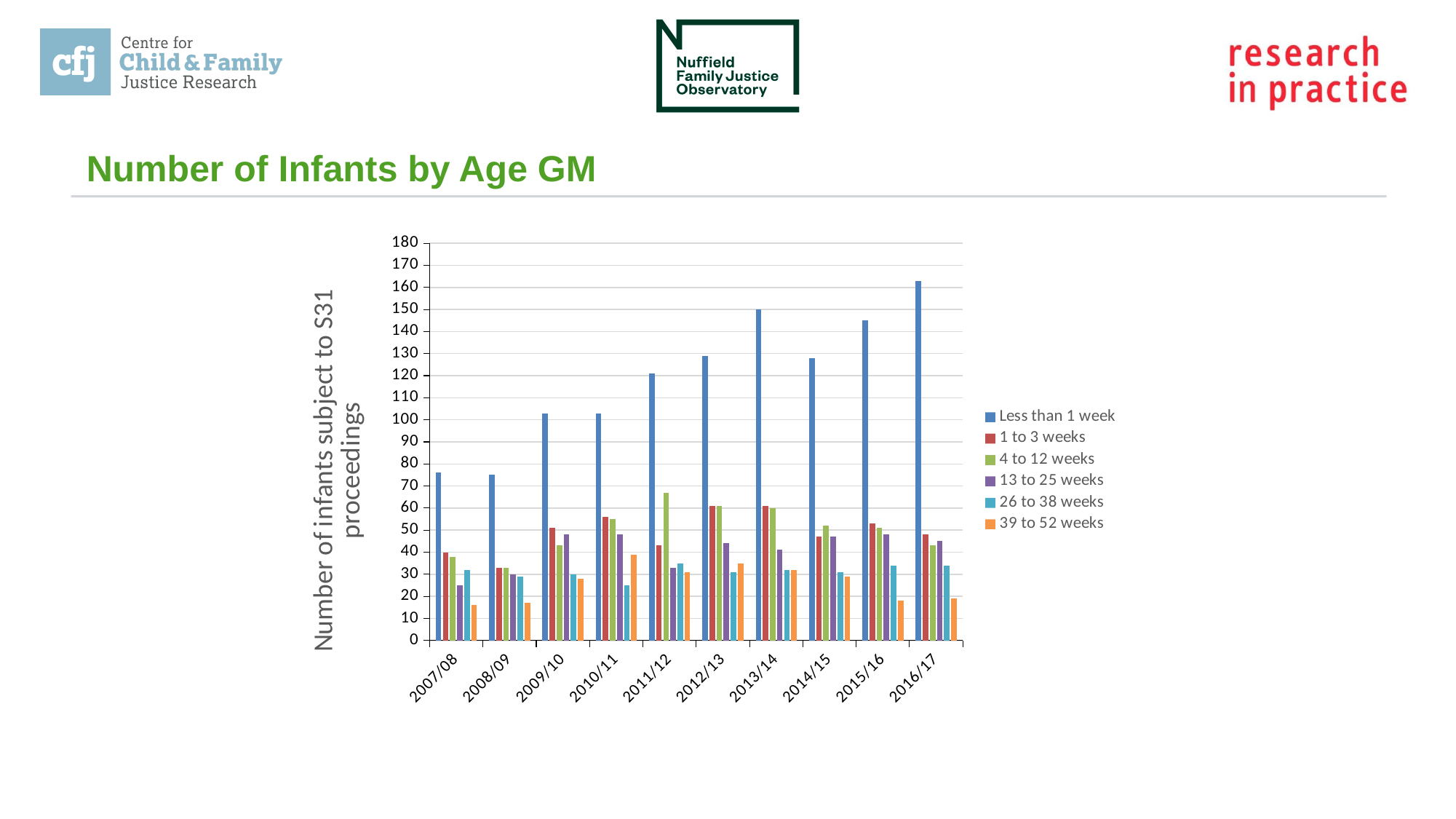
How many series does the legend list? 6 Does the 'Less than 1 week' series generally rise or fall from 2007/08 to 2016/17? rise What kind of chart is shown on the slide? bar chart In which year is the value for 'Less than 1 week' highest? 2016/17 What is the title of the y axis? Number of infants subject to S31 proceedings Is the value for '4 to 12 weeks' in 2011/12 greater or less than 60? greater Is the value for 'Less than 1 week' in 2016/17 greater or less than 150? greater In which year is the value for '39 to 52 weeks' highest? 2010/11 Is the value for '39 to 52 weeks' in 2007/08 greater or less than 20? less Which is larger: the 'Less than 1 week' value in 2011/12 or in 2013/14? 2013/14 How many year categories are shown on the x axis? 10